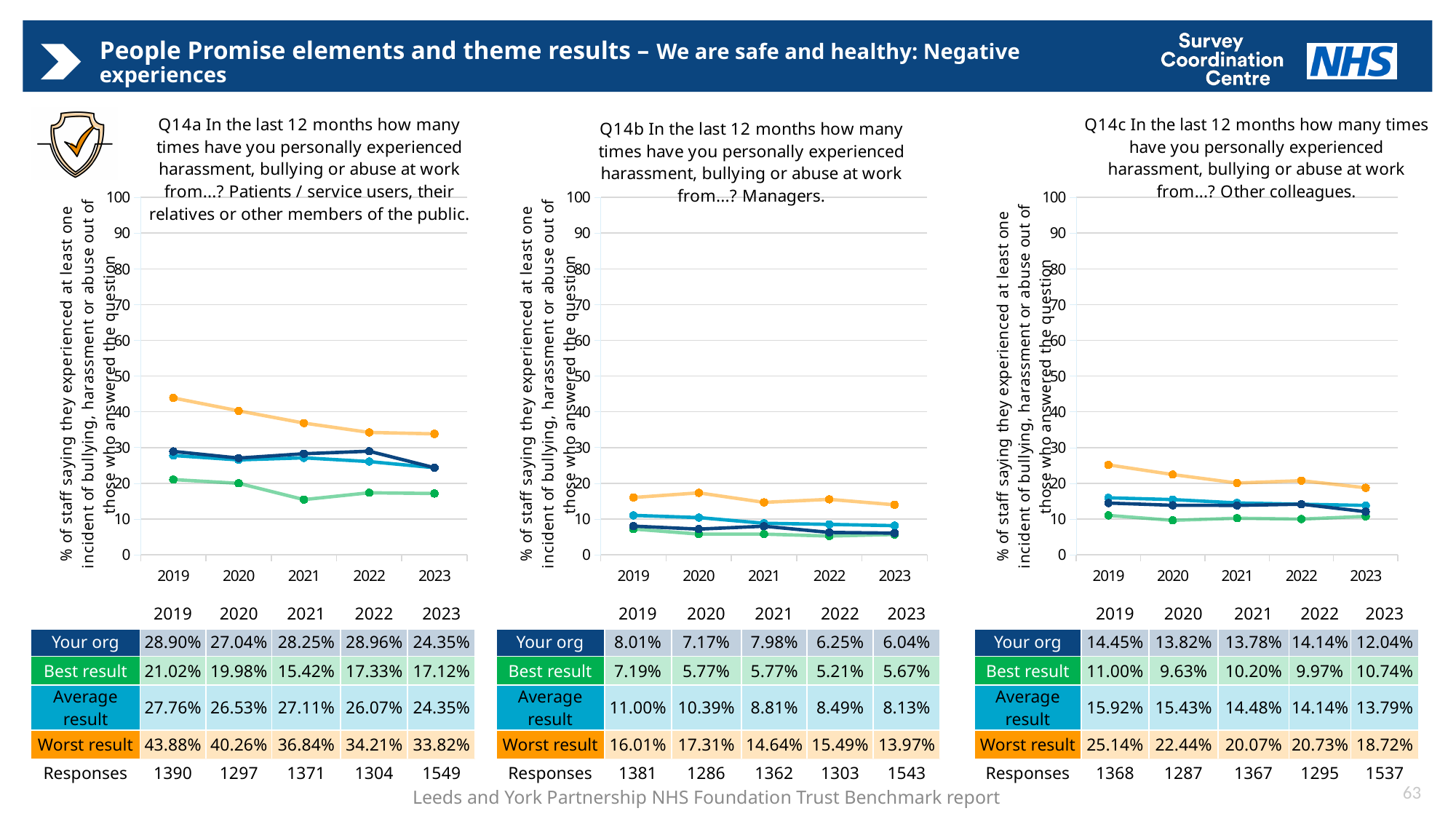
How many charts are shown on the slide? 3 In the left chart (Q14a), which year has the highest 'Worst result' value? 2019 In the right chart (Q14c), does the 'Worst result' line generally rise or fall from 2019 to 2023? Fall In the middle chart (Q14b), is the 'Worst result' value for 2019 greater or less than 20? less How many years are plotted on the x axis of the right chart (Q14c)? 5 In the middle chart (Q14b), which year has the lowest 'Your org' value? 2023 In the right chart (Q14c, other colleagues), what is the 'Best result' value for 2021? 10.20% What type of chart is used for Q14a on the left of the slide? Line chart In the right chart (Q14c), what is the difference between the 'Worst result' and 'Your org' values for 2019? 10.69% In the left chart (Q14a, patients / service users), what is the 'Your org' value for 2023? 24.35% In the middle chart (Q14b, managers), what is the 'Worst result' value for 2020? 17.31% In the left chart (Q14a), which is larger in 2022: the 'Your org' value or the 'Average result' value? Your org